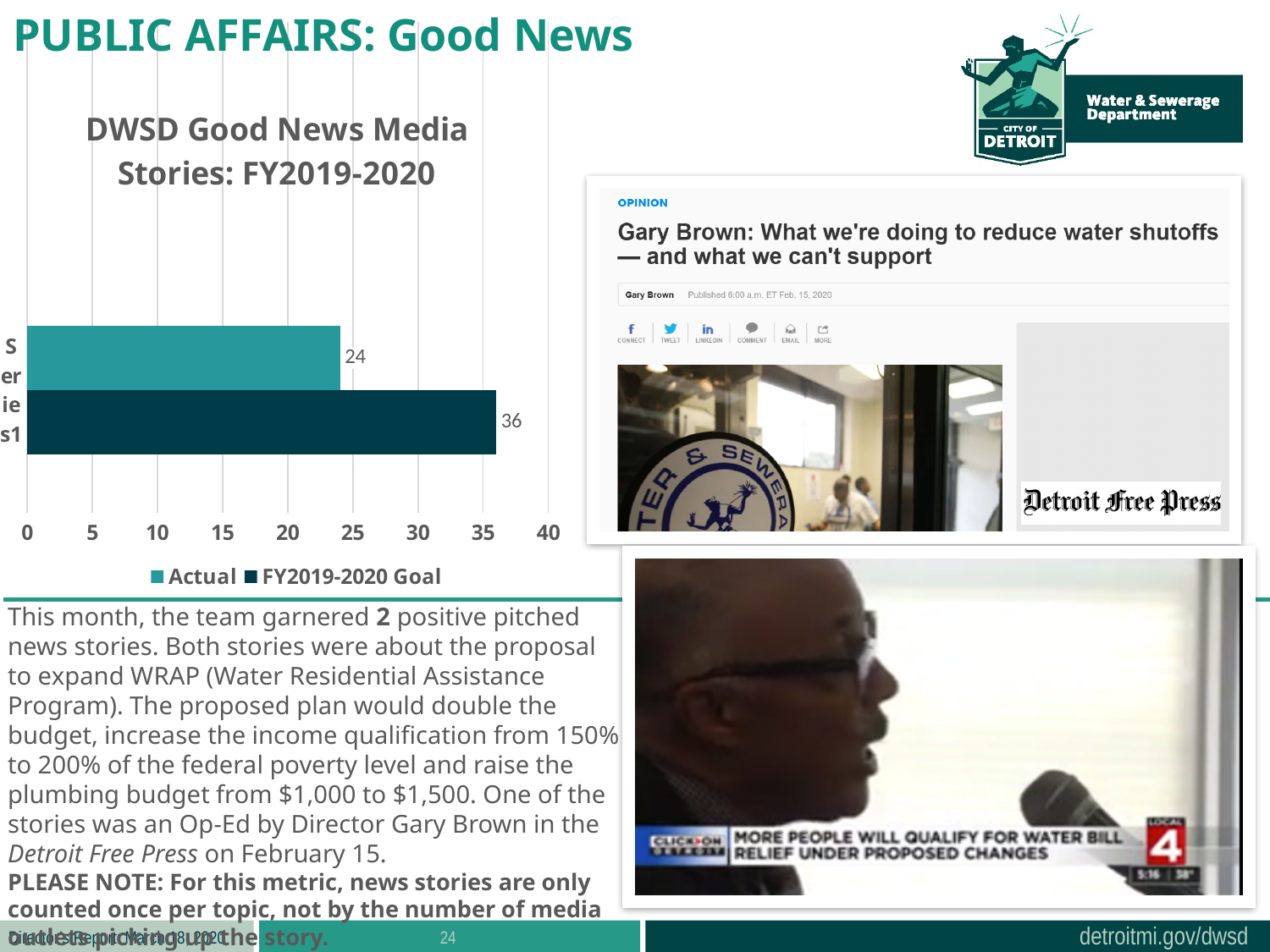
What type of chart is shown on the slide? Bar chart Is the FY2019-2020 Goal value in the chart greater or less than 30? greater Is the Actual value in the chart greater or less than 25? less Which series has the highest value in the DWSD Good News Media Stories chart? FY2019-2020 Goal How many series does the legend of the chart list? 2 What is the value of the FY2019-2020 Goal bar in the DWSD Good News Media Stories chart? 36 Which series has the lowest value in the DWSD Good News Media Stories chart? Actual What is the title of the chart on the slide? DWSD Good News Media Stories: FY2019-2020 What is the value of the Actual bar in the DWSD Good News Media Stories chart? 24 Which is larger in the chart, the Actual value or the FY2019-2020 Goal? FY2019-2020 Goal By how much does the FY2019-2020 Goal exceed the Actual value in the chart? 12 What is the maximum value shown on the chart's horizontal axis? 40